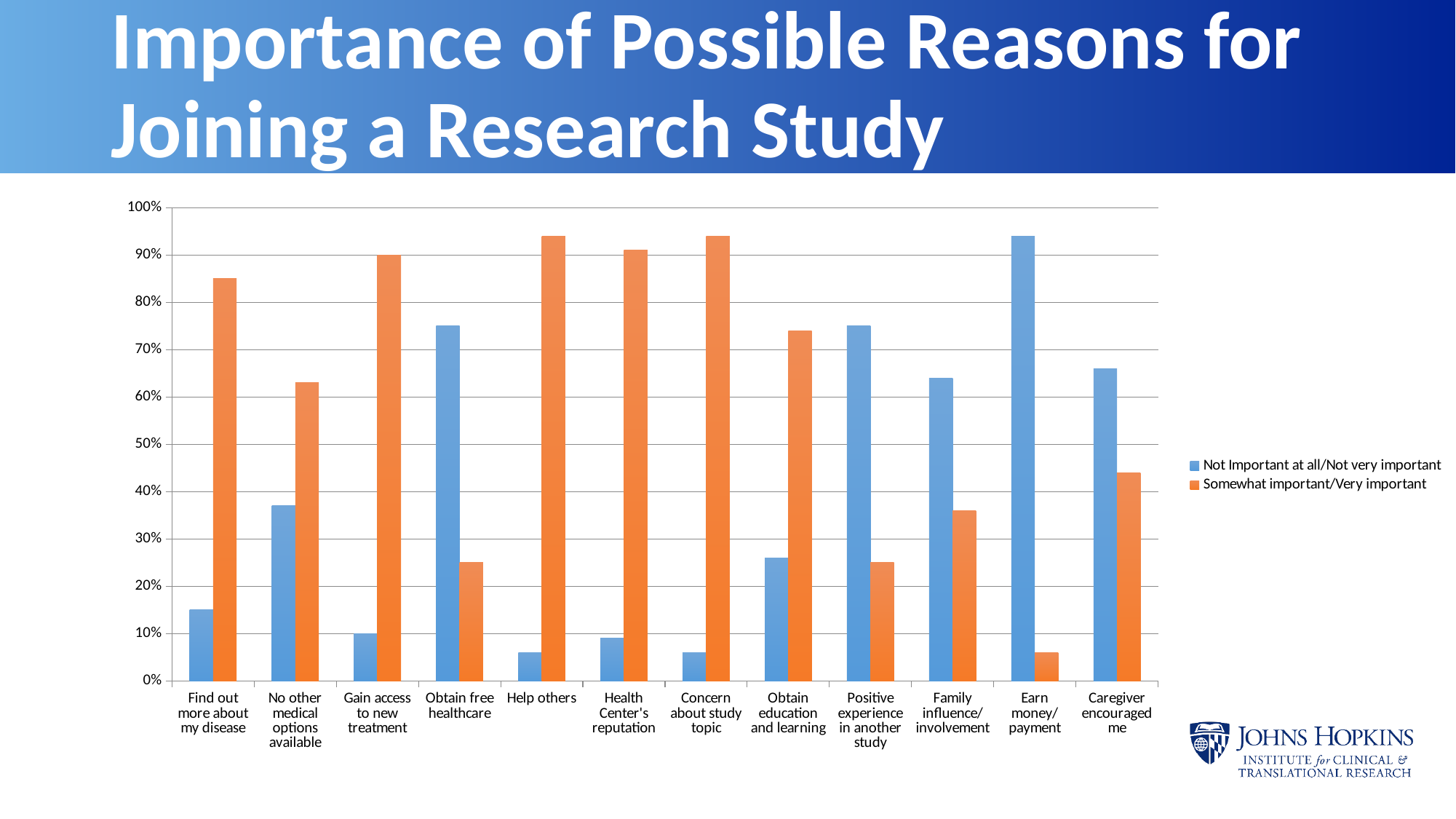
What colour are the bars for the 'Somewhat important/Very important' series? orange How many reasons (categories) are shown along the x axis? 12 Is the 'Not Important at all/Not very important' value for 'Earn money/payment' greater or less than 90%? greater For 'Obtain free healthcare', which series has the larger value? Not Important at all/Not very important Is the 'Somewhat important/Very important' value for 'Help others' greater or less than 90%? greater For 'Caregiver encouraged me', which series has the larger value? Not Important at all/Not very important How many series does the legend list? 2 What kind of chart is shown on the slide? bar chart Is the 'Not Important at all/Not very important' value for 'Find out more about my disease' greater or less than 20%? less Which reason has the lowest 'Somewhat important/Very important' value? Earn money/payment Which reason has the highest 'Not Important at all/Not very important' value? Earn money/payment